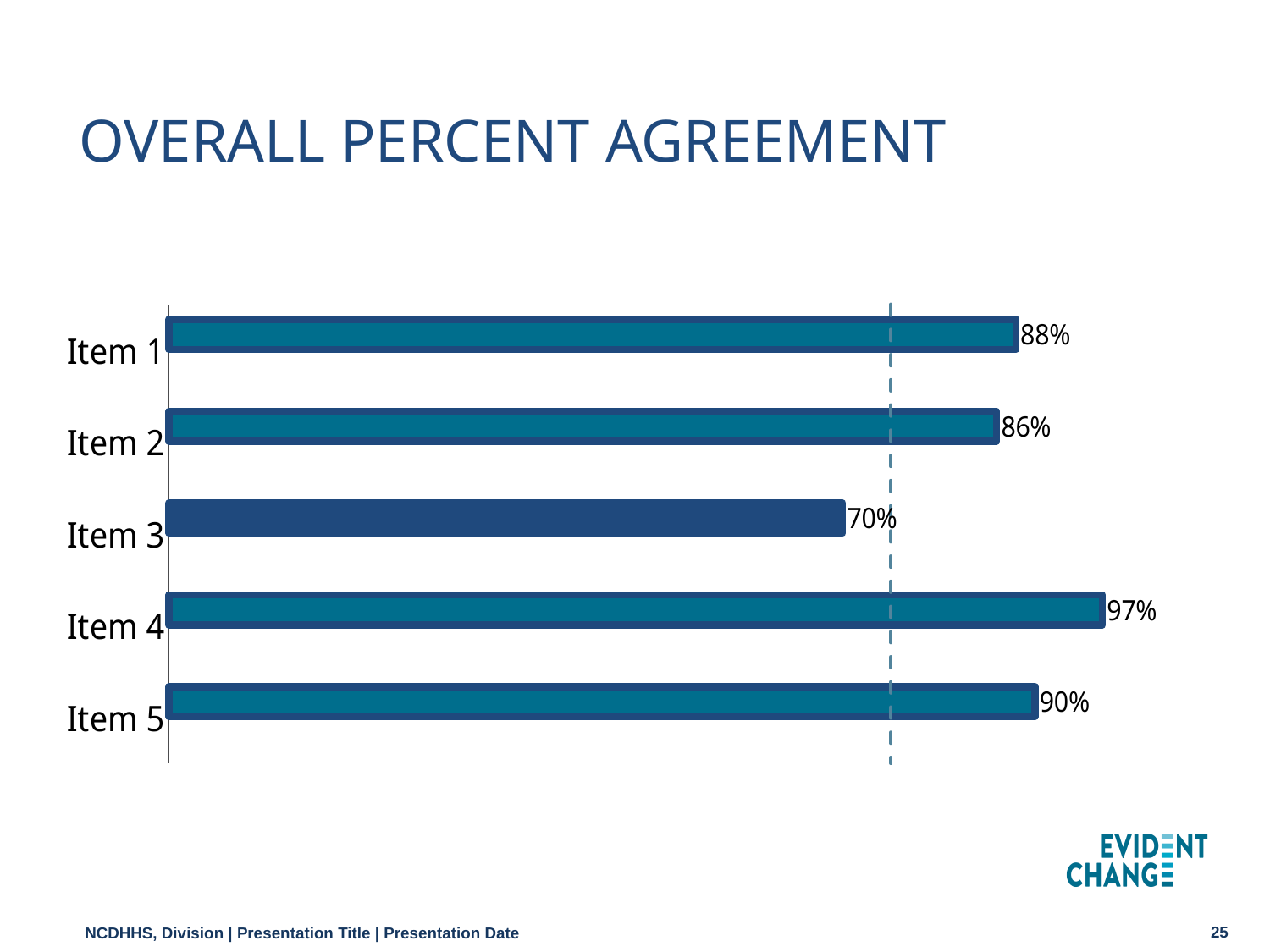
Which is larger, the value for Item 5 or the value for Item 2? Item 5 Which item has the highest percent agreement? Item 4 Which item's bar is shown in a different (darker) colour from the others? Item 3 What is the value for Item 1? 88% What is the value for Item 3? 70% What is the title of the slide? OVERALL PERCENT AGREEMENT What is the value for Item 5? 90% What is the difference between the values for Item 4 and Item 3? 27% What kind of chart is shown on the slide? Bar chart How many items are shown in the chart? 5 What is the difference between the values for Item 1 and Item 2? 2% Which item has the lowest percent agreement? Item 3